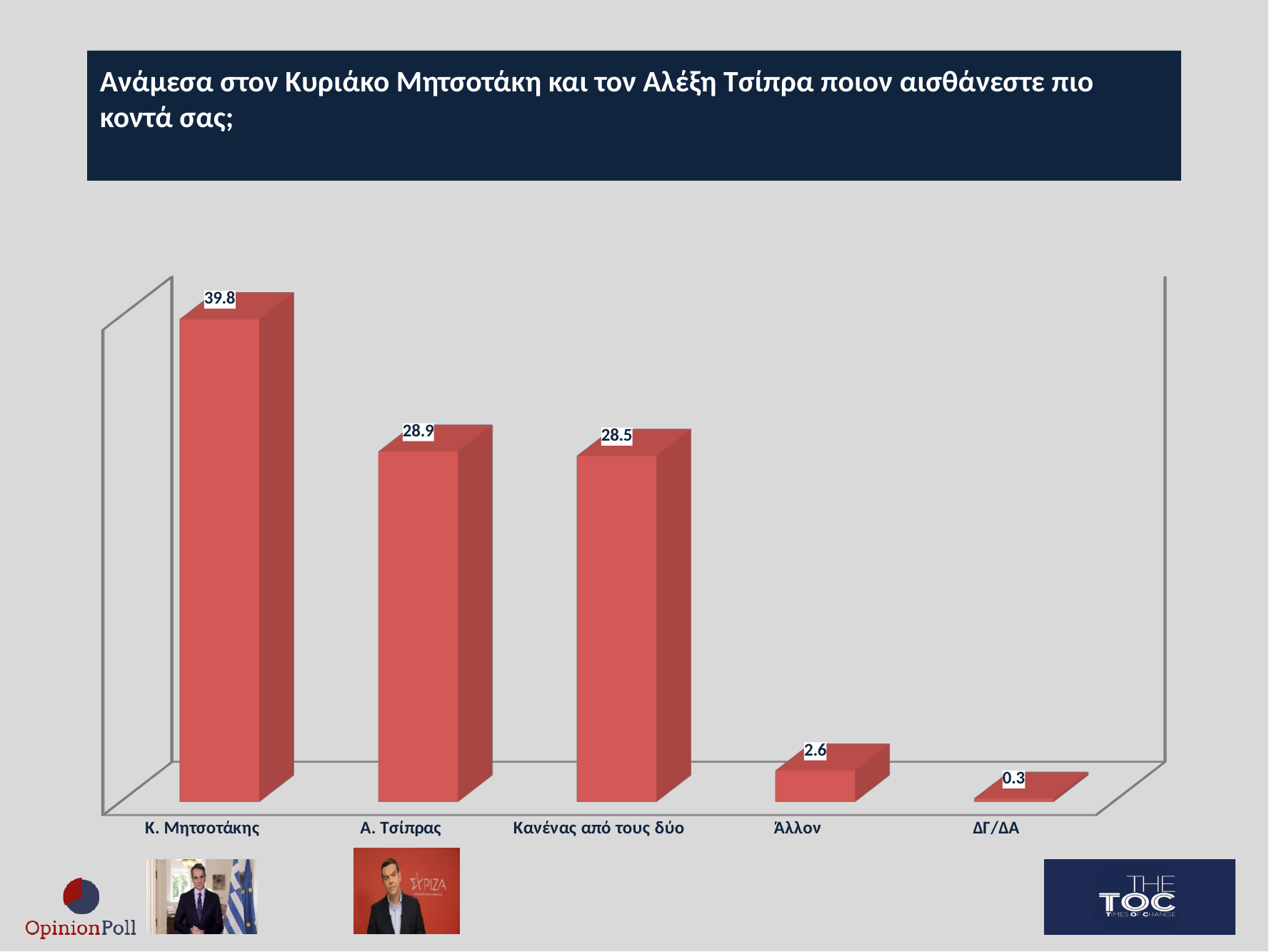
What is the value for Κανένας από τους δύο? 28.5 What is the value for Α. Τσίπρας? 28.9 What is the difference between the values for Άλλον and ΔΓ/ΔΑ? 2.3 What kind of chart is shown on the slide? Bar chart What is the difference between the values for Κ. Μητσοτάκης and Α. Τσίπρας? 10.9 Which category has the lowest value? ΔΓ/ΔΑ What is the value for Άλλον? 2.6 How many categories are shown in the chart? 5 Which category has the highest value? Κ. Μητσοτάκης Which is larger, the value for Κ. Μητσοτάκης or the value for Κανένας από τους δύο? Κ. Μητσοτάκης What is the value for Κ. Μητσοτάκης? 39.8 What is the value for ΔΓ/ΔΑ? 0.3